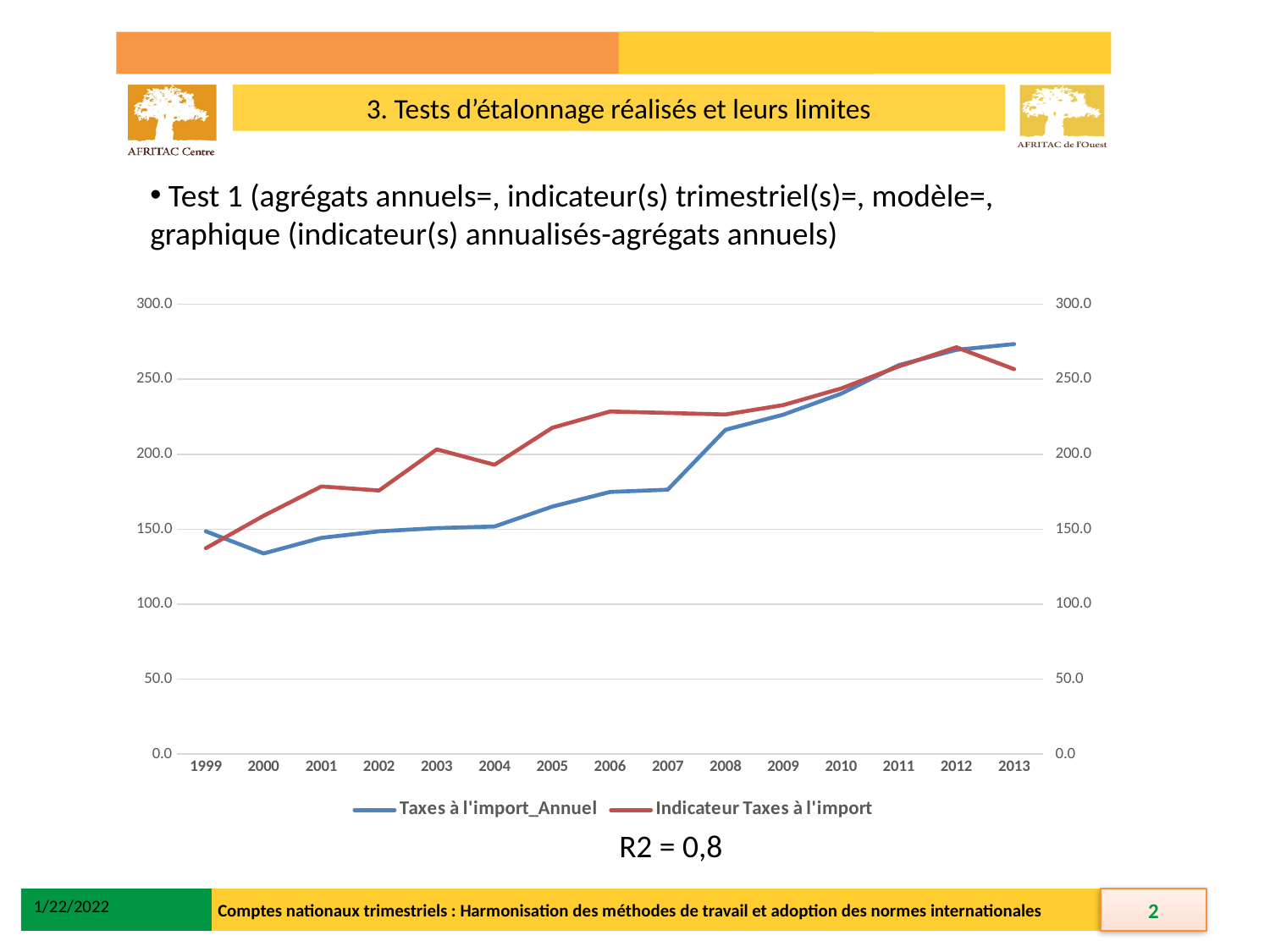
How many years are plotted along the x axis of the chart? 15 Which two series are listed in the chart legend? Taxes à l'import_Annuel and Indicateur Taxes à l'import In which year does the Indicateur Taxes à l'import series reach its highest value? 2012 What R2 value is printed below the chart? R2 = 0,8 In 2005, which series has the larger value, Taxes à l'import_Annuel or Indicateur Taxes à l'import? Indicateur Taxes à l'import In which year is the Indicateur Taxes à l'import series at its lowest? 1999 In which year does the Taxes à l'import_Annuel series reach its highest value? 2013 How many series does the chart legend list? 2 Is the value of Taxes à l'import_Annuel in 2008 greater or less than 200.0? greater What kind of chart is shown on the slide? line chart Does the Taxes à l'import_Annuel series generally rise or fall from 1999 to 2013? rise In which year is the Taxes à l'import_Annuel series at its lowest? 2000